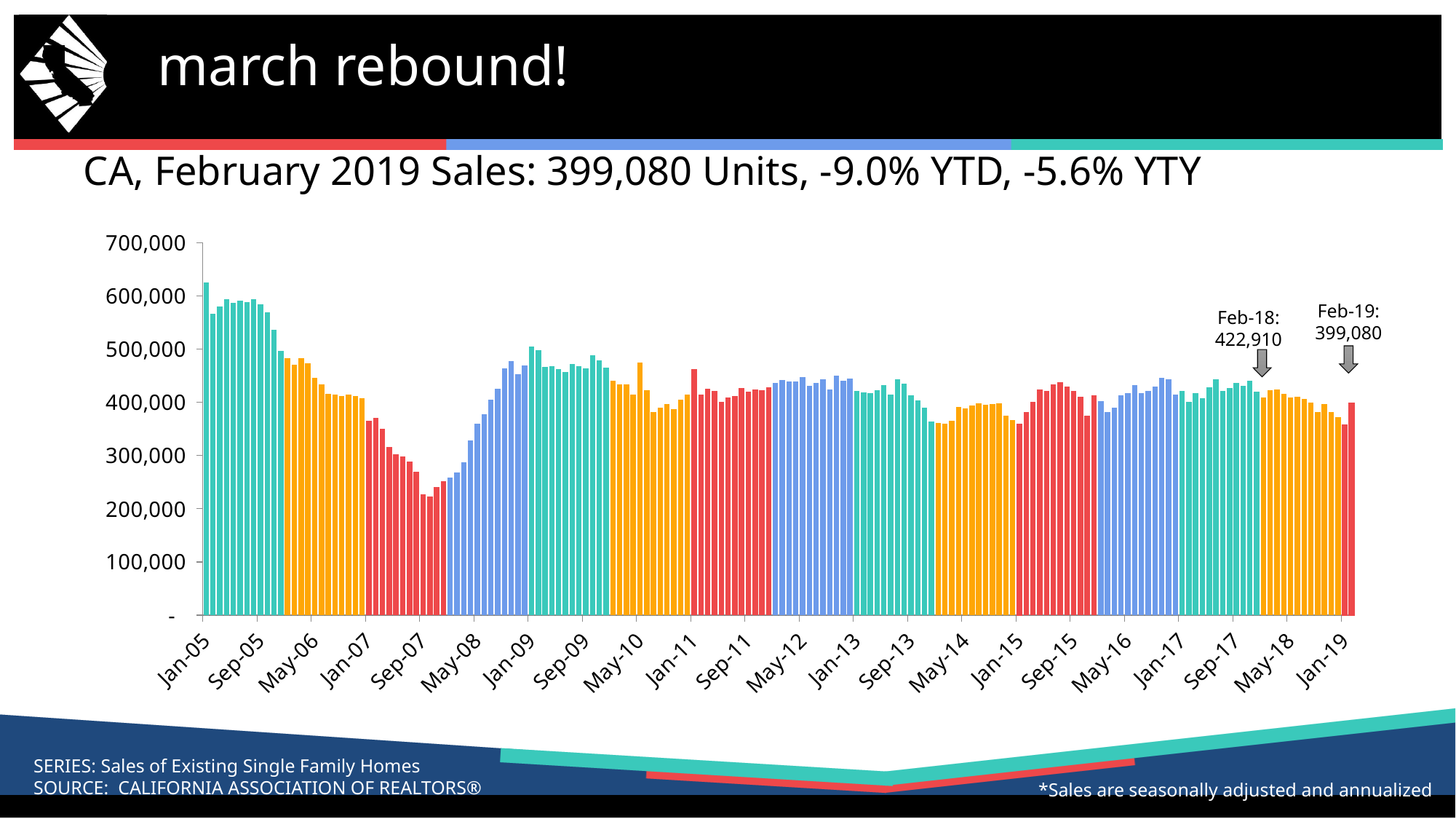
Which is larger, the value for Feb-18 or the value for Feb-19? Feb-18 What is the value for Feb-18 on the chart? 422,910 Is the value for Sep-07 greater or less than 400,000? less What is the difference between the Feb-18 and Feb-19 values? 23,830 Is the value for Jan-05 greater or less than 600,000? greater What kind of chart is shown on the slide? bar chart Which month has the highest value on the chart? Jan-05 Do the values rise or fall from Jan-05 to Sep-07? fall What is the value for Feb-19 on the chart? 399,080 Is the value for Sep-05 greater or less than 500,000? greater What is the title of the chart? CA, February 2019 Sales: 399,080 Units, -9.0% YTD, -5.6% YTY What is the first month label on the x axis? Jan-05